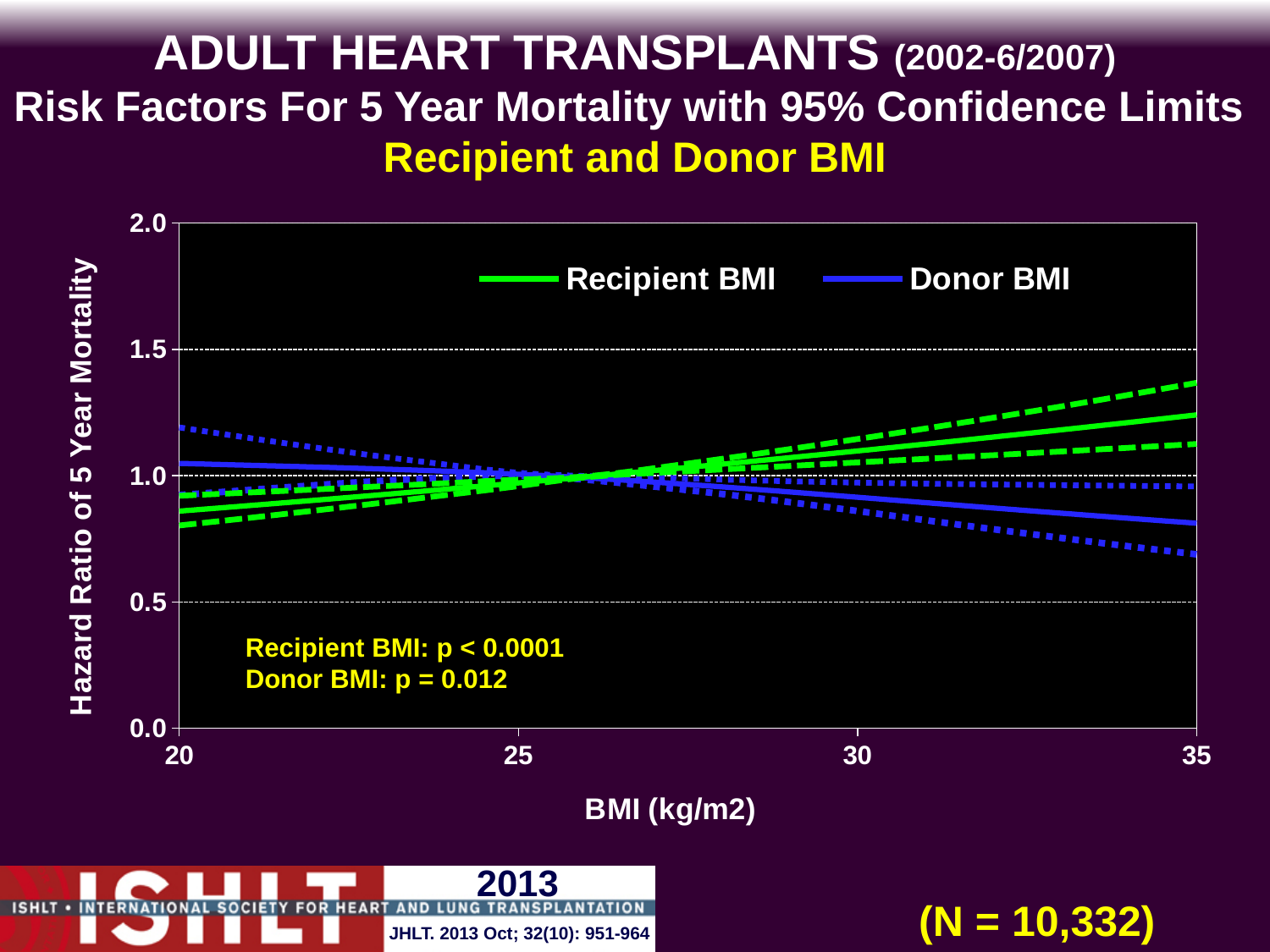
Does the Recipient BMI hazard ratio rise or fall as BMI increases from 20 to 35? rise How many tick labels are shown on the BMI (x) axis? 4 How many series does the legend list? 2 What p-value is given for Recipient BMI on the chart? p < 0.0001 At a BMI of 20, which series has the higher hazard ratio, Recipient BMI or Donor BMI? Donor BMI At a BMI of 20, is the Recipient BMI hazard ratio greater or less than 1.0? less What colour is the Donor BMI line in the legend? blue At a BMI of 35, is the Recipient BMI hazard ratio greater or less than 1.0? greater What kind of chart is shown on the slide? line chart At a BMI of 35, which series has the higher hazard ratio, Recipient BMI or Donor BMI? Recipient BMI At a BMI of 35, is the Donor BMI hazard ratio greater or less than 1.0? less Does the Donor BMI hazard ratio rise or fall as BMI increases from 20 to 35? fall